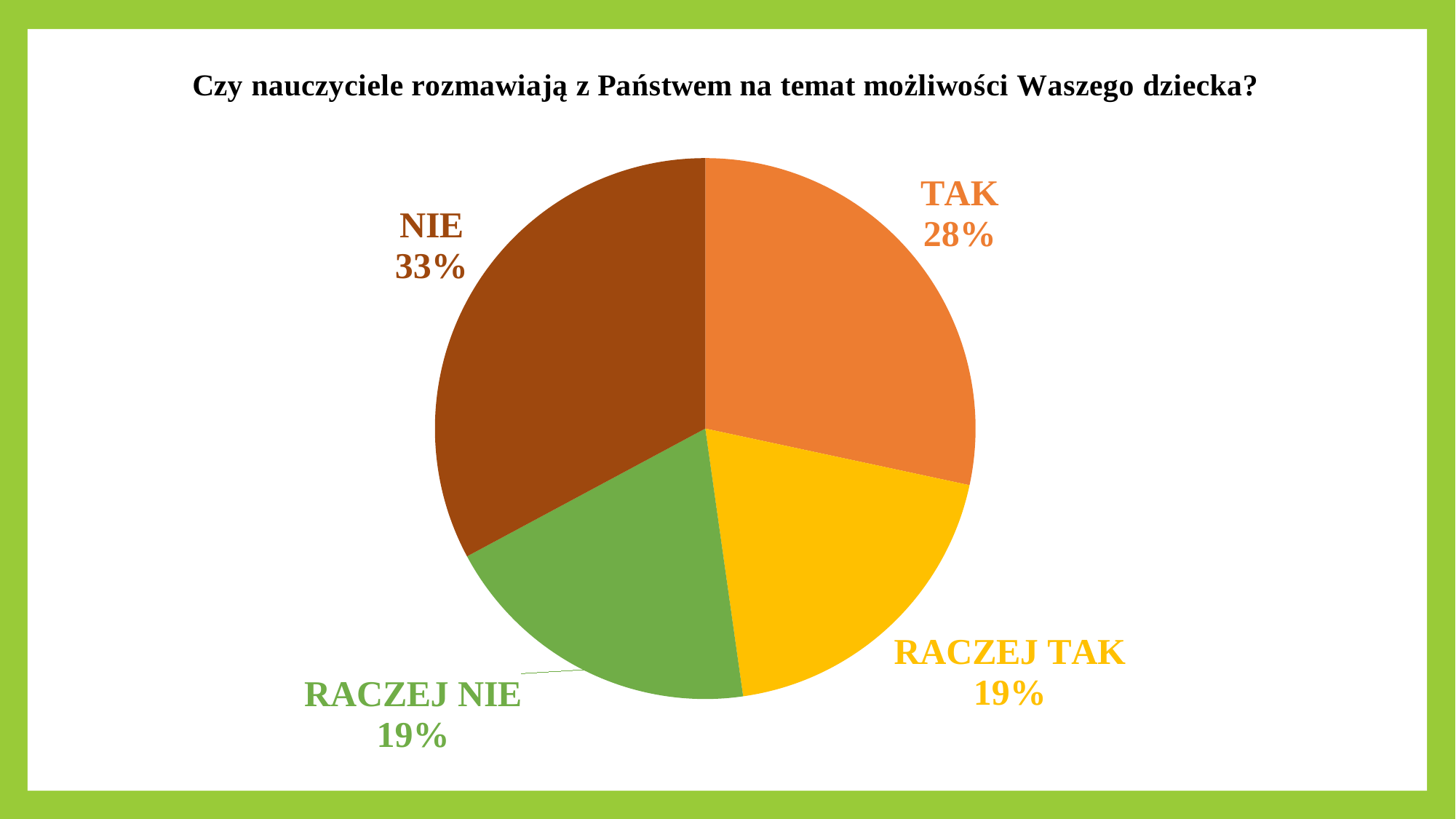
Which is larger, the share for NIE or the share for TAK? NIE What percentage of respondents answered RACZEJ TAK? 19% Which answer has the largest share of the pie? NIE What percentage of respondents answered TAK? 28% What is the title of the chart? Czy nauczyciele rozmawiają z Państwem na temat możliwości Waszego dziecka? What is the combined share of TAK and RACZEJ TAK? 47% What percentage of respondents answered NIE? 33% How many slices does the pie chart have? 4 What percentage of respondents answered RACZEJ NIE? 19% What is the difference in percentage points between TAK and RACZEJ TAK? 9 What is the difference in percentage points between NIE and TAK? 5 What kind of chart is shown on the slide? pie chart